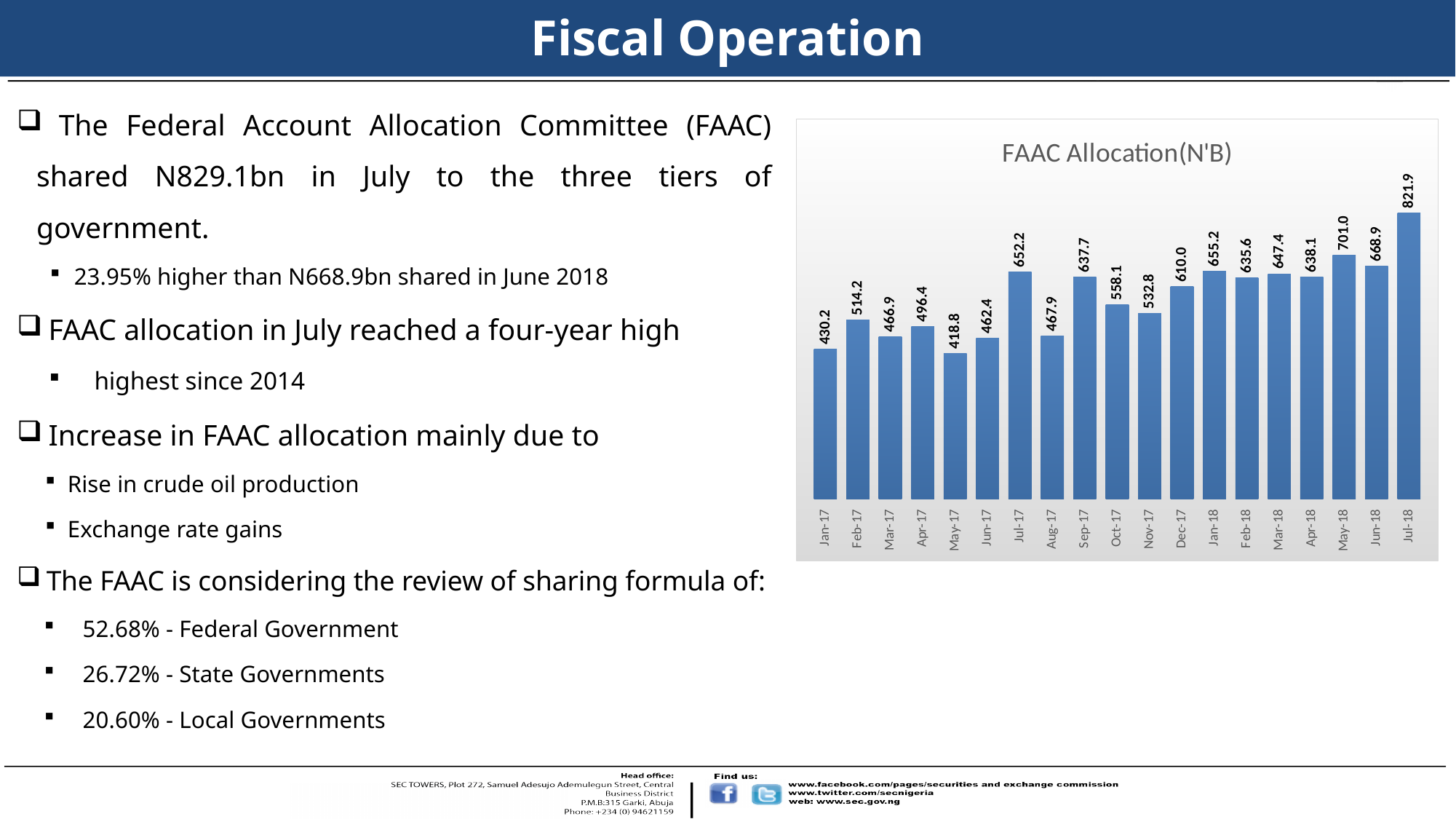
Which is larger, the FAAC allocation for Jul-17 or Sep-17? Jul-17 What is the difference between the FAAC allocation in Feb-17 and Jan-17? 84.0 What is the FAAC allocation for Dec-17? 610.0 What is the difference between the FAAC allocation in Jul-18 and Jun-18? 153.0 Which month has the lowest FAAC allocation? May-17 What kind of chart is shown on the slide? Bar chart Which month has the highest FAAC allocation? Jul-18 What is the FAAC allocation for Jul-18? 821.9 What is the FAAC allocation for May-17? 418.8 Does the FAAC allocation rise or fall from Jan-17 to Jul-18 overall? Rise How many months are plotted in the chart? 19 What is the title of the chart? FAAC Allocation(N'B)